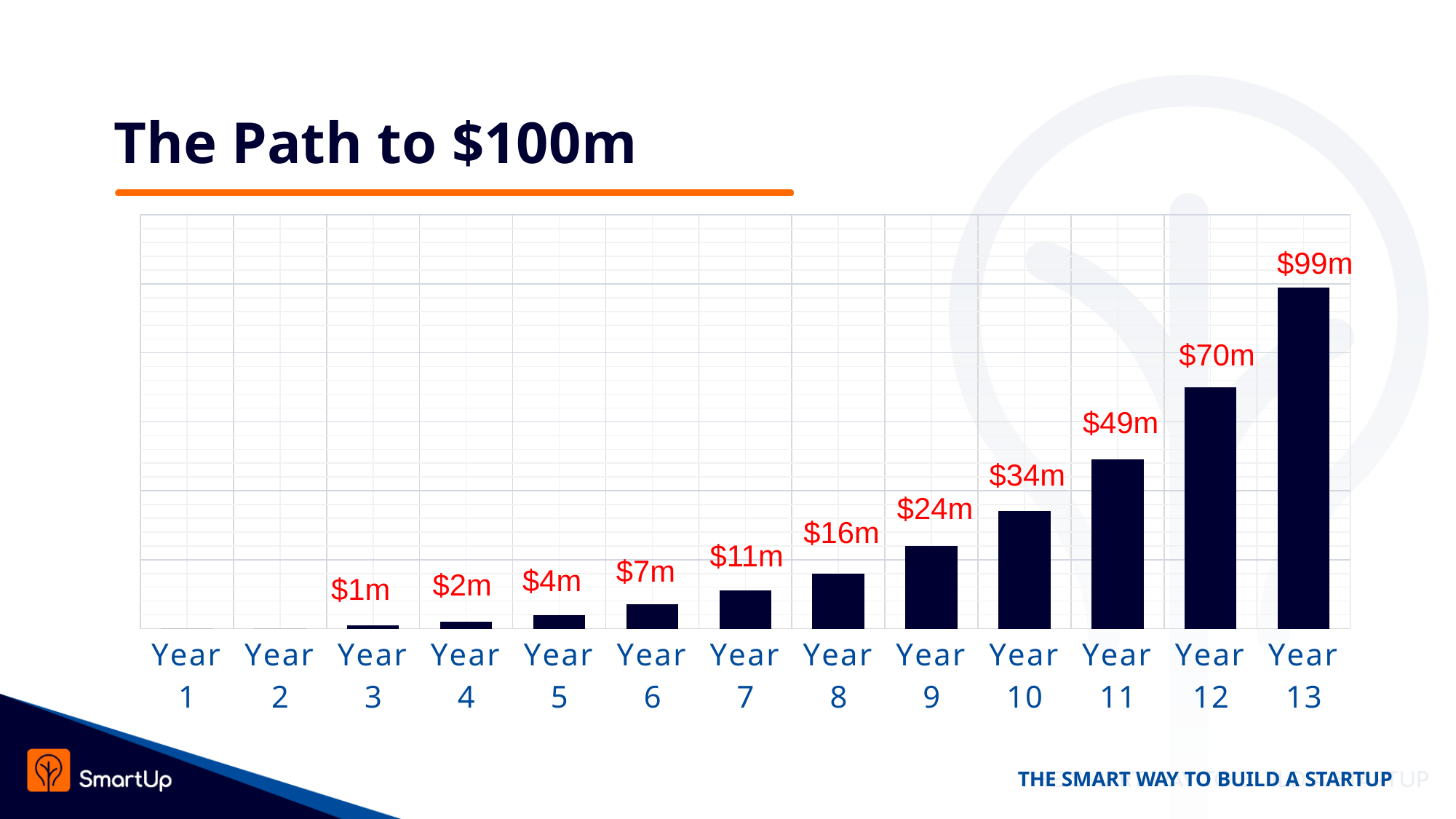
What kind of chart is shown on the slide? Bar chart What is the value for Year 5? $4m Do the values rise or fall from Year 3 to Year 13? Rise What is the value for Year 11? $49m How many years are shown on the x axis? 13 Which year has the highest value? Year 13 What is the difference between the values for Year 13 and Year 12? $29m What is the value for Year 13? $99m What is the difference between the values for Year 10 and Year 9? $10m Which is larger, the value for Year 7 or the value for Year 9? Year 9 What is the value for Year 8? $16m What is the title of the chart? The Path to $100m